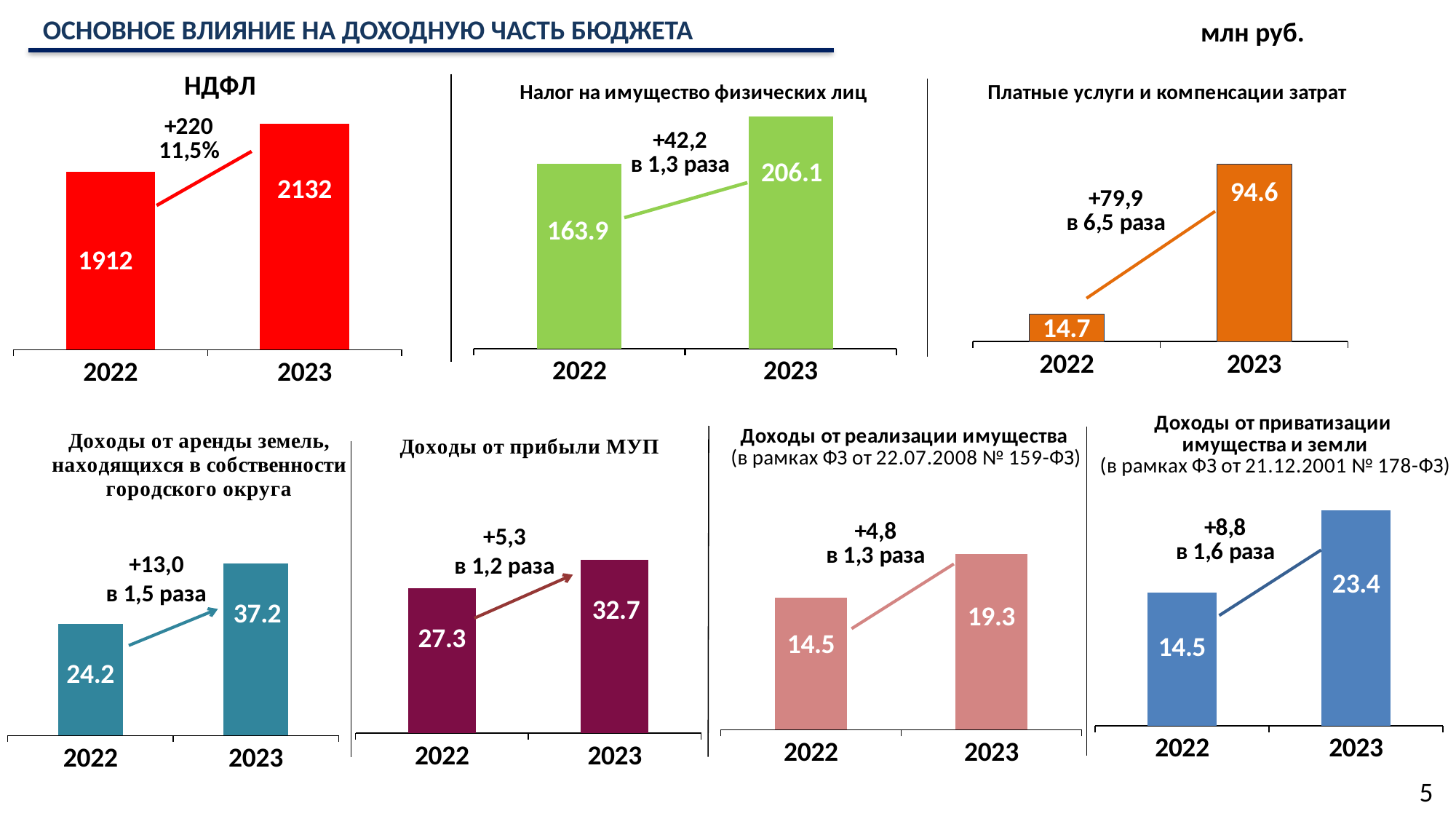
In the Налог на имущество физических лиц chart, what is the difference between the 2023 and 2022 values? 42.2 In the Налог на имущество физических лиц chart, what is the value for 2023? 206.1 In the Платные услуги и компенсации затрат chart, what is the value for 2022? 14.7 In the НДФЛ chart, what is the value for 2022? 1912 In the Платные услуги и компенсации затрат chart, which year has the higher value? 2023 In the Доходы от приватизации имущества и земли chart, what is the value for 2023? 23.4 In the Доходы от аренды земель chart, what is the value for 2023? 37.2 In the НДФЛ chart, what is the difference between the 2023 and 2022 values? 220 How many charts are shown on the slide? 7 In the Доходы от прибыли МУП chart, what is the value for 2022? 27.3 What type of chart is the НДФЛ chart? Bar chart In the Доходы от реализации имущества chart, what is the difference between the 2023 and 2022 values? 4.8